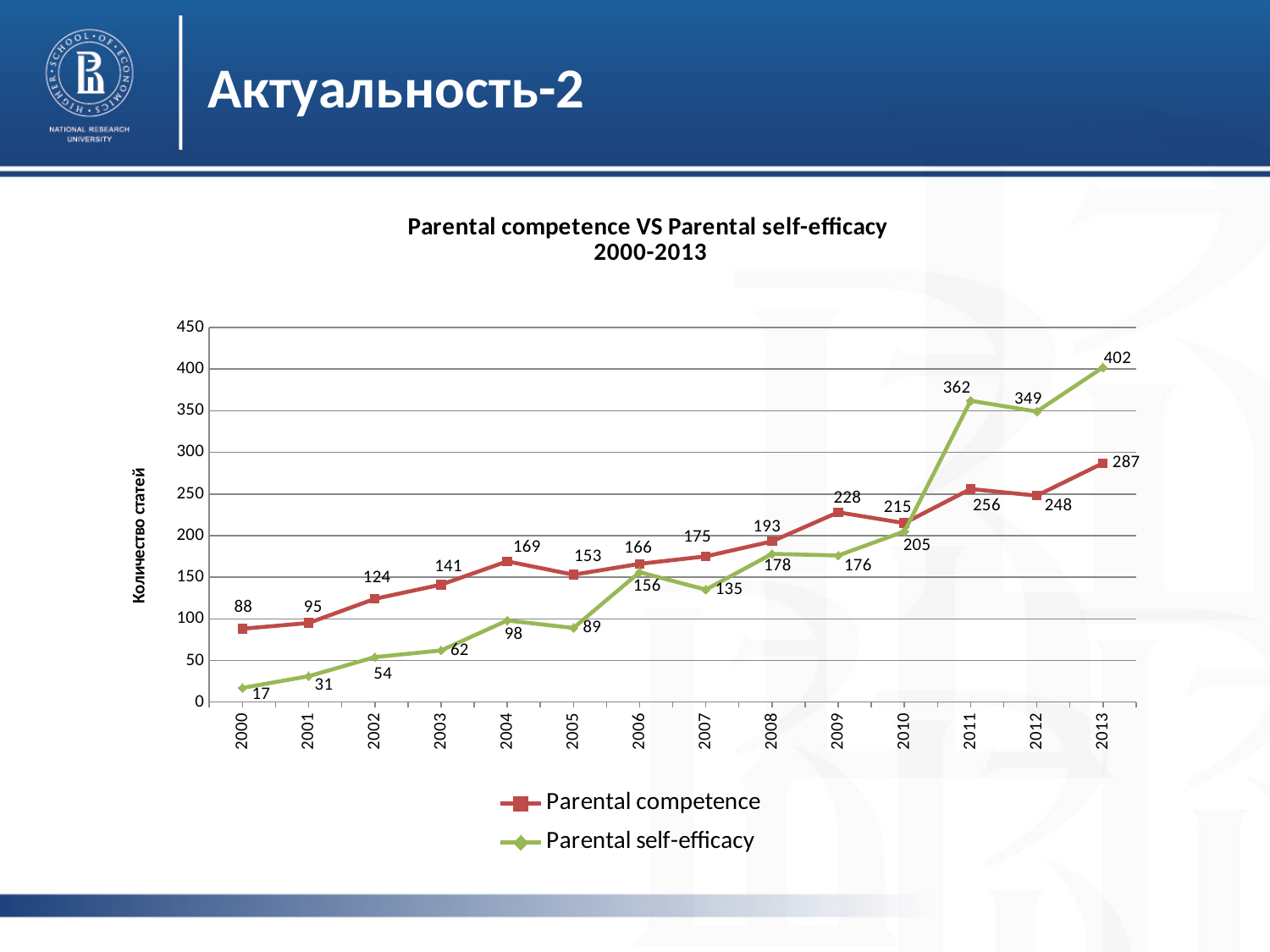
In which year is Parental competence at its lowest value? 2000 What is the value for Parental competence in 2009? 228 Which series has the larger value in 2008, Parental competence or Parental self-efficacy? Parental competence What kind of chart is shown on the slide? Line chart What is the difference between Parental self-efficacy and Parental competence in 2013? 115 What is the title of the chart? Parental competence VS Parental self-efficacy 2000-2013 How many years are shown on the x axis? 14 Which series has the larger value in 2012, Parental competence or Parental self-efficacy? Parental self-efficacy What is the value for Parental self-efficacy in 2000? 17 What is the value for Parental self-efficacy in 2011? 362 How many series does the legend list? 2 In which year does Parental self-efficacy reach its highest value? 2013